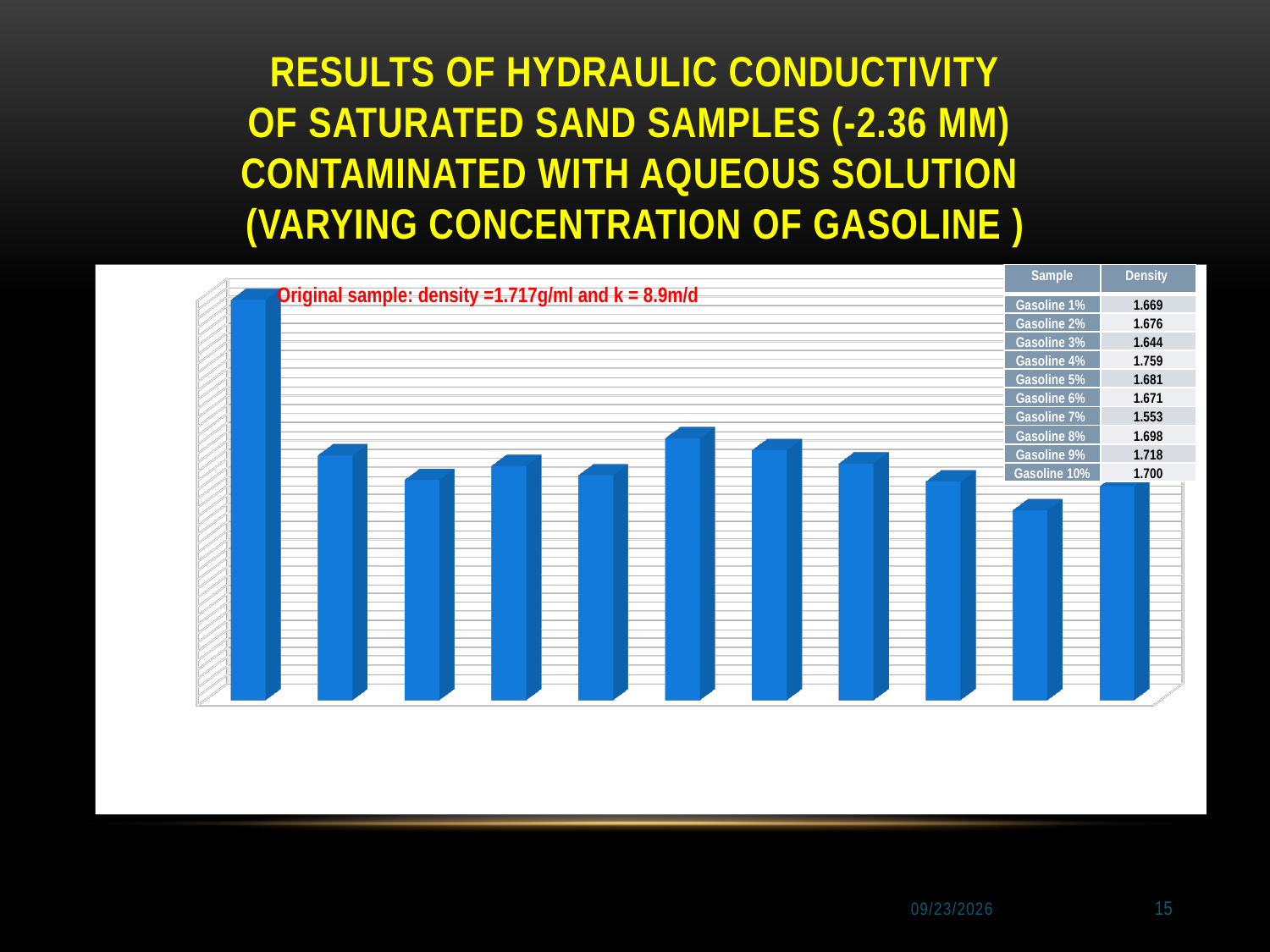
What kind of chart is shown on the slide? bar chart Which is taller, the first bar from the left or the second bar from the left? the first bar What colour are the bars in the chart? blue Which bar in the chart is the tallest? the leftmost (first) bar Which bar in the chart is the shortest? the tenth bar (second from the right) Which is taller, the fourth bar from the left or the sixth bar from the left? the sixth bar According to the red annotation on the chart, what are the density and k of the original sample? density =1.717g/ml and k = 8.9m/d Which is taller, the third bar from the left or the seventh bar from the left? the seventh bar How many bars are plotted in the chart? 11